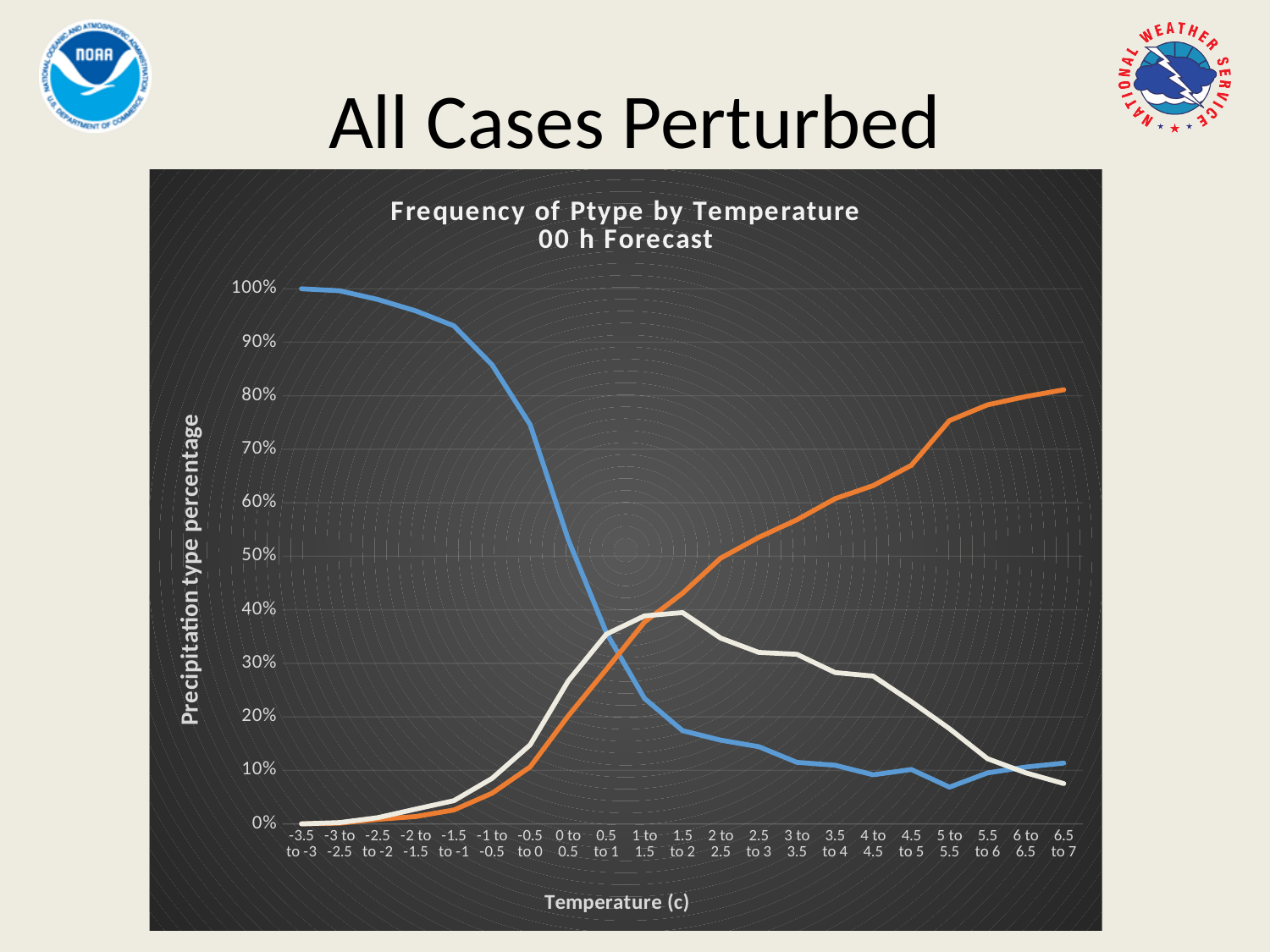
What is the title of the chart? Frequency of Ptype by Temperature 00 h Forecast How many temperature bins are shown along the x axis? 21 Does the blue line rise or fall as temperature increases along the x axis? fall What kind of chart is shown on the slide? line chart At -3.5 to -3, which line has the larger value, the blue line or the orange line? blue line At 6.5 to 7, which line has the larger value, the orange line or the blue line? orange line Is the value of the blue line at -3.5 to -3 greater or less than 90%? greater Is the value of the orange line at -0.5 to 0 greater or less than 20%? less What is the label of the vertical axis? Precipitation type percentage Does the orange line rise or fall as temperature increases along the x axis? rise How many lines are plotted on the chart? 3 Is the value of the orange line at 6.5 to 7 greater or less than 70%? greater